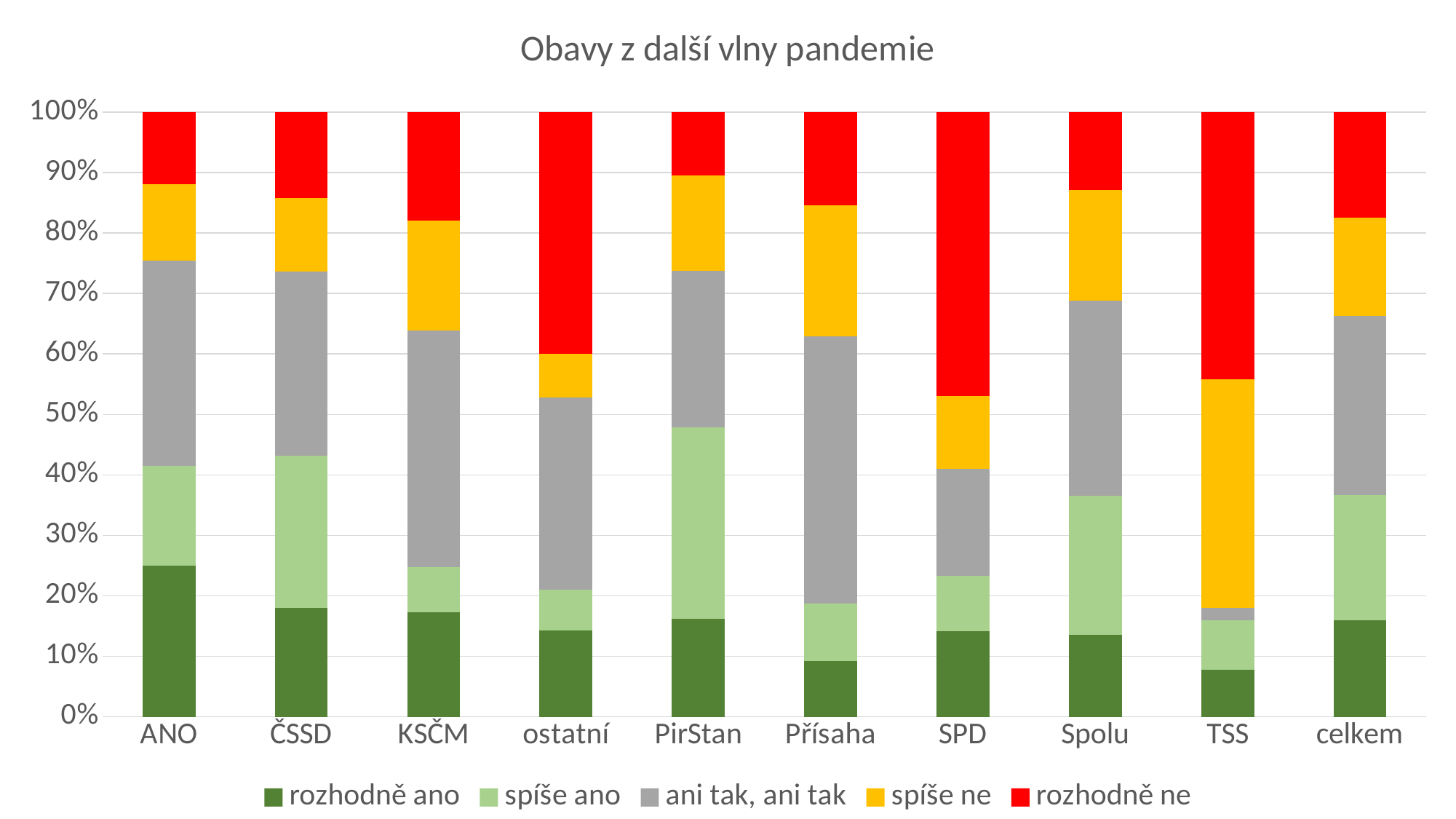
Which is larger, the 'rozhodně ano' segment for ANO or for TSS? ANO Which category has the largest 'spíše ano' segment? PirStan Is the 'rozhodně ano' value for ANO greater or less than 20%? greater Which category has the largest 'rozhodně ano' segment? ANO What is the title of the chart? Obavy z další vlny pandemie Is the 'rozhodně ano' value for TSS greater or less than 10%? less What kind of chart is shown on the slide? stacked bar chart Is the 'rozhodně ne' value for SPD greater or less than 40%? greater Which category has the largest 'spíše ne' segment? TSS How many categories are shown on the x axis? 10 How many series does the legend list? 5 What is the total of the stacked bar for celkem? 100%